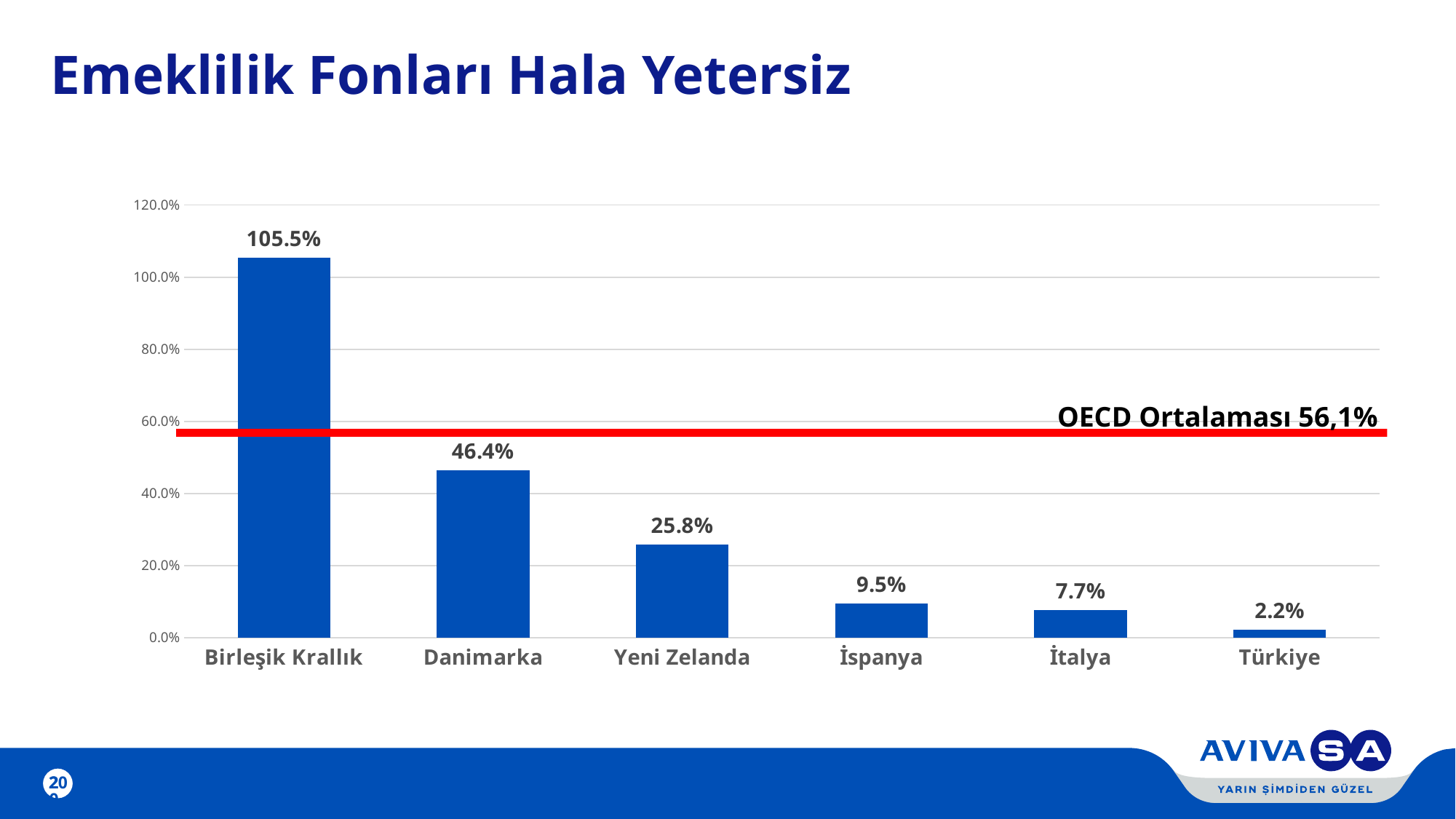
Which country has the highest value? Birleşik Krallık How many countries are shown on the chart? 6 What value does the red horizontal line labelled OECD Ortalaması represent? 56,1% Do the values rise or fall from left to right along the x axis? fall What is the value for Türkiye? 2.2% Which country has the lowest value? Türkiye What kind of chart is shown on the slide? bar chart What is the value for Danimarka? 46.4% Which is larger, the value for İspanya or the value for İtalya? İspanya Is the value for Yeni Zelanda greater or less than 40.0%? less What is the difference between the values for Danimarka and Yeni Zelanda? 20.6% What is the value for Birleşik Krallık? 105.5%